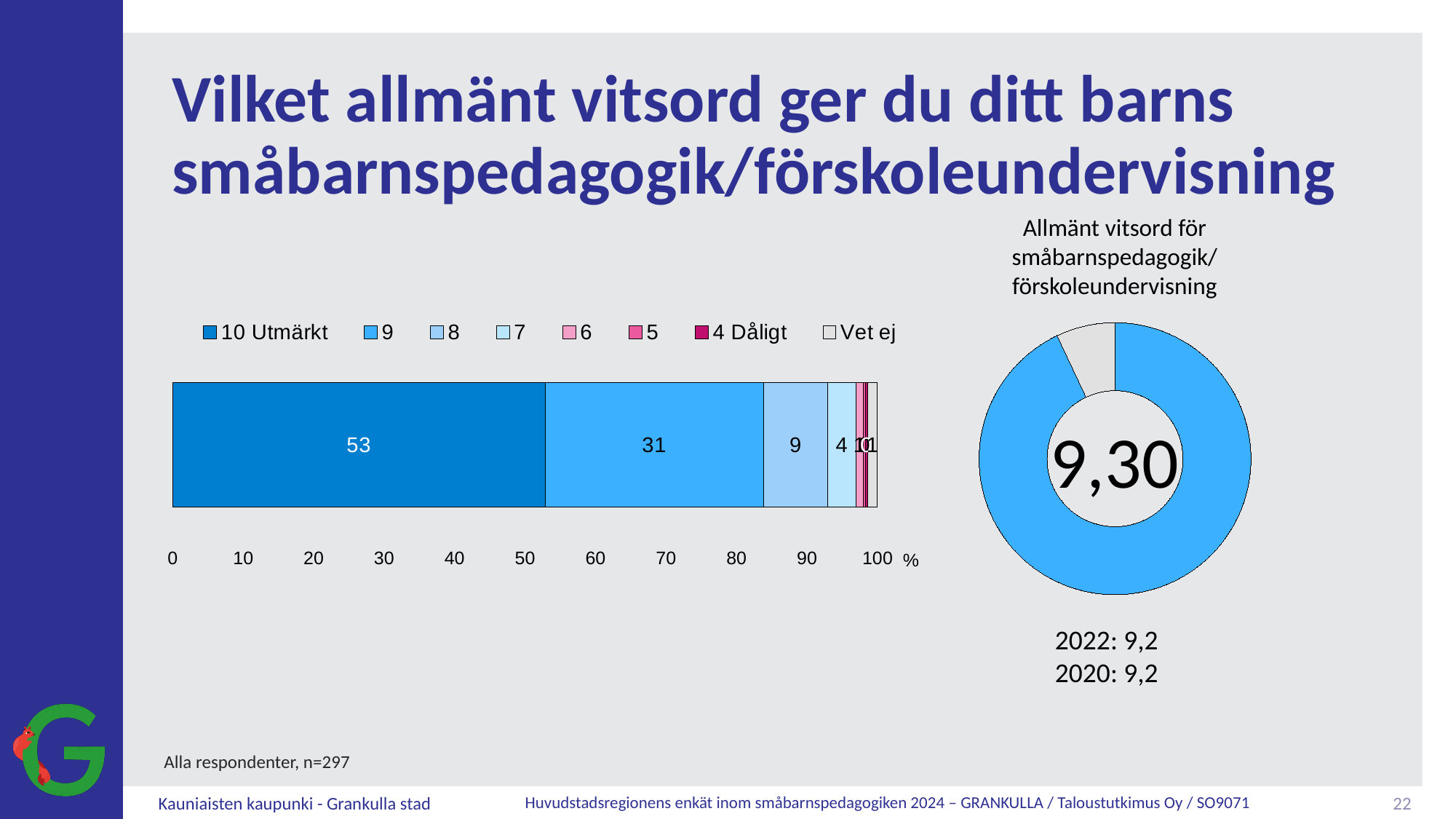
What value is shown in the centre of the doughnut chart titled "Allmänt vitsord för småbarnspedagogik/förskoleundervisning"? 9,30 In the stacked bar chart on the left, which segment is larger: grade 9 or grade 8? 9 In the stacked bar chart on the left, what is the difference in percentage points between the "10 Utmärkt" segment and the 9 segment? 22 In the stacked bar chart on the left, what percentage of respondents gave the grade 8? 9 What kind of chart is the chart on the left of the slide? Stacked bar chart In the stacked bar chart on the left, what percentage of respondents gave the grade 7? 4 How many series does the legend of the stacked bar chart on the left list? 8 In the stacked bar chart on the left, is the value for "10 Utmärkt" greater or less than 50? greater In the stacked bar chart on the left, what percentage of respondents gave the grade "10 Utmärkt"? 53 In the stacked bar chart on the left, what percentage of respondents gave the grade 9? 31 What kind of chart is the chart on the right of the slide? Doughnut chart In the stacked bar chart on the left, which grade category has the largest share? 10 Utmärkt